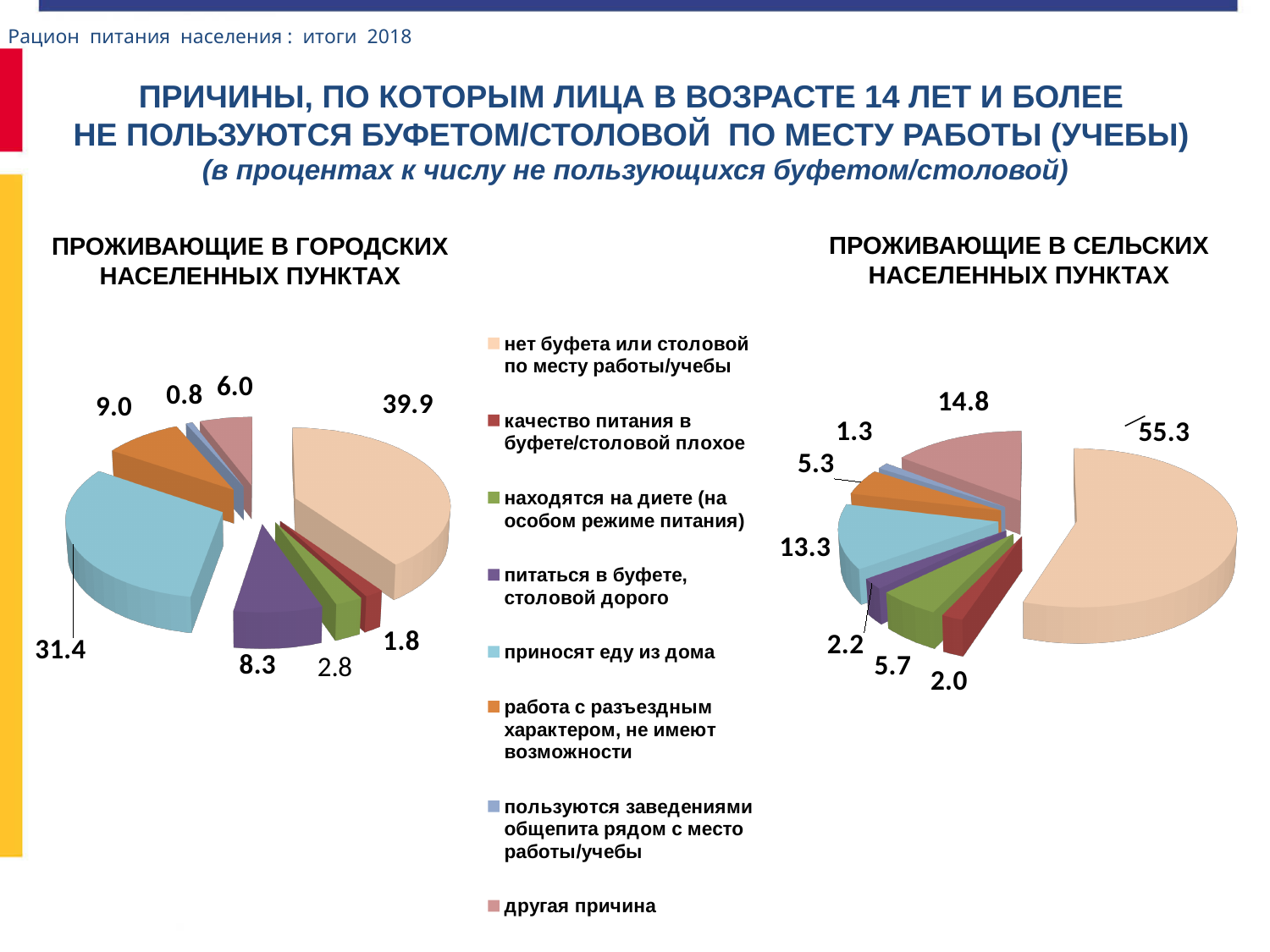
In the chart for urban residents, what is the value for 'питаться в буфете, столовой дорого'? 8.3 In the rural chart, which is larger: 'находятся на диете (на особом режиме питания)' or 'питаться в буфете, столовой дорого'? находятся на диете (на особом режиме питания) In the chart for rural residents (ПРОЖИВАЮЩИЕ В СЕЛЬСКИХ НАСЕЛЕННЫХ ПУНКТАХ), what is the value for 'приносят еду из дома'? 13.3 What is the difference between the 'нет буфета или столовой по месту работы/учебы' values in the rural chart and the urban chart? 15.4 What type of chart is used for the urban residents data? pie chart In the chart for urban residents (ПРОЖИВАЮЩИЕ В ГОРОДСКИХ НАСЕЛЕННЫХ ПУНКТАХ), what is the value for 'нет буфета или столовой по месту работы/учебы'? 39.9 In the urban chart, which is larger: 'приносят еду из дома' or 'работа с разъездным характером, не имеют возможности'? приносят еду из дома In the chart for rural residents, what is the value for 'другая причина'? 14.8 In the chart for urban residents, which category has the smallest share? пользуются заведениями общепита рядом с место работы/учебы In the chart for rural residents, which category has the largest share? нет буфета или столовой по месту работы/учебы In the urban chart, what is the difference between 'приносят еду из дома' and 'другая причина'? 25.4 How many categories does the legend list for the pie charts? 8